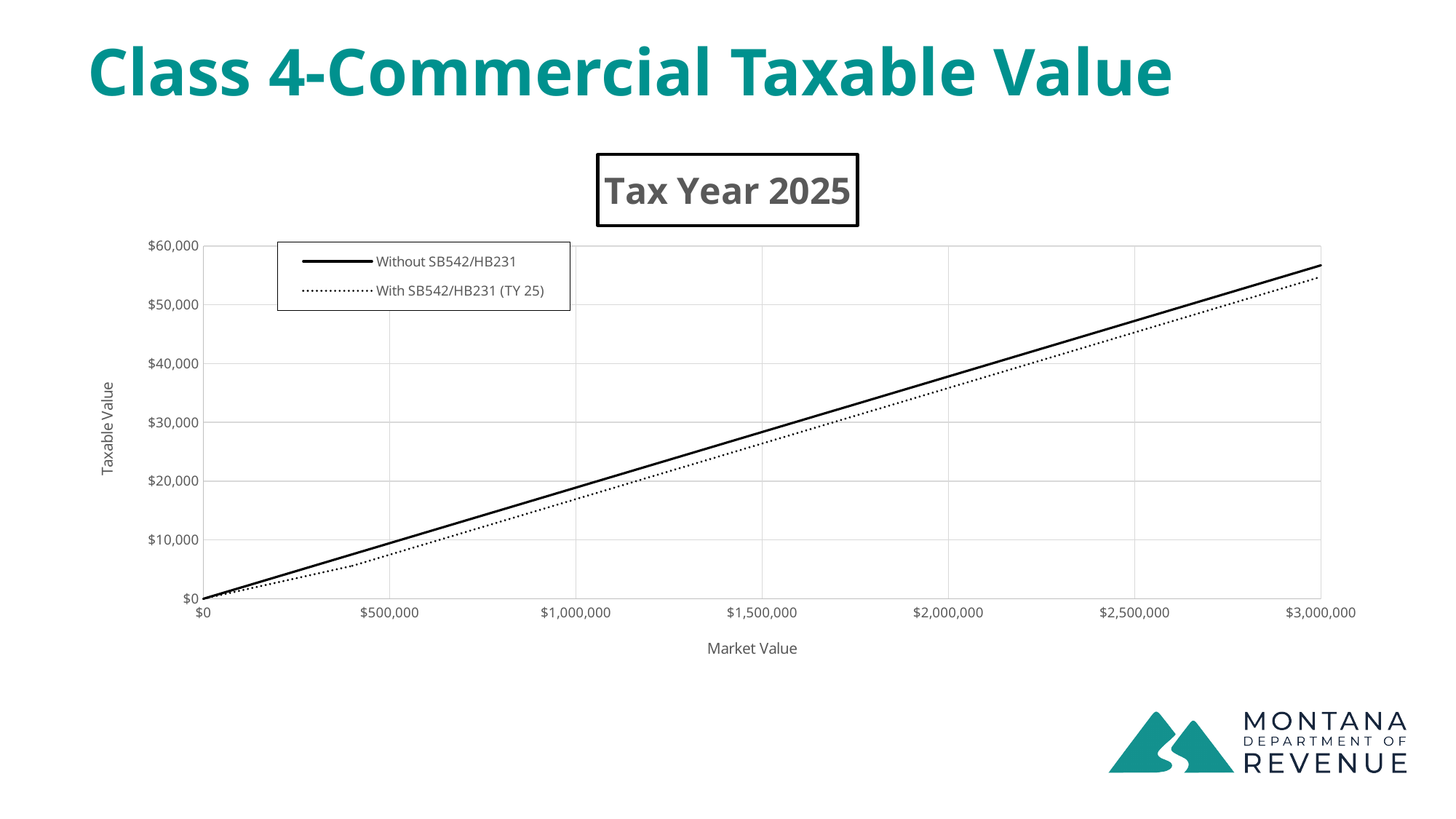
Is the taxable value for Without SB542/HB231 at a market value of $3,000,000 greater or less than $50,000? greater Is the taxable value for With SB542/HB231 (TY 25) at a market value of $1,000,000 greater or less than $20,000? less What is the title shown above the chart? Tax Year 2025 What kind of chart is shown on the slide? Line chart Is the taxable value for With SB542/HB231 (TY 25) at a market value of $500,000 greater or less than $10,000? less Does the taxable value for Without SB542/HB231 rise or fall as market value increases? Rise Does the taxable value for With SB542/HB231 (TY 25) rise or fall as market value increases? Rise How many series does the legend list? 2 What is the taxable value for Without SB542/HB231 at a market value of $0? $0 What is the label of the x axis? Market Value At a market value of $2,000,000, which series has the higher taxable value? Without SB542/HB231